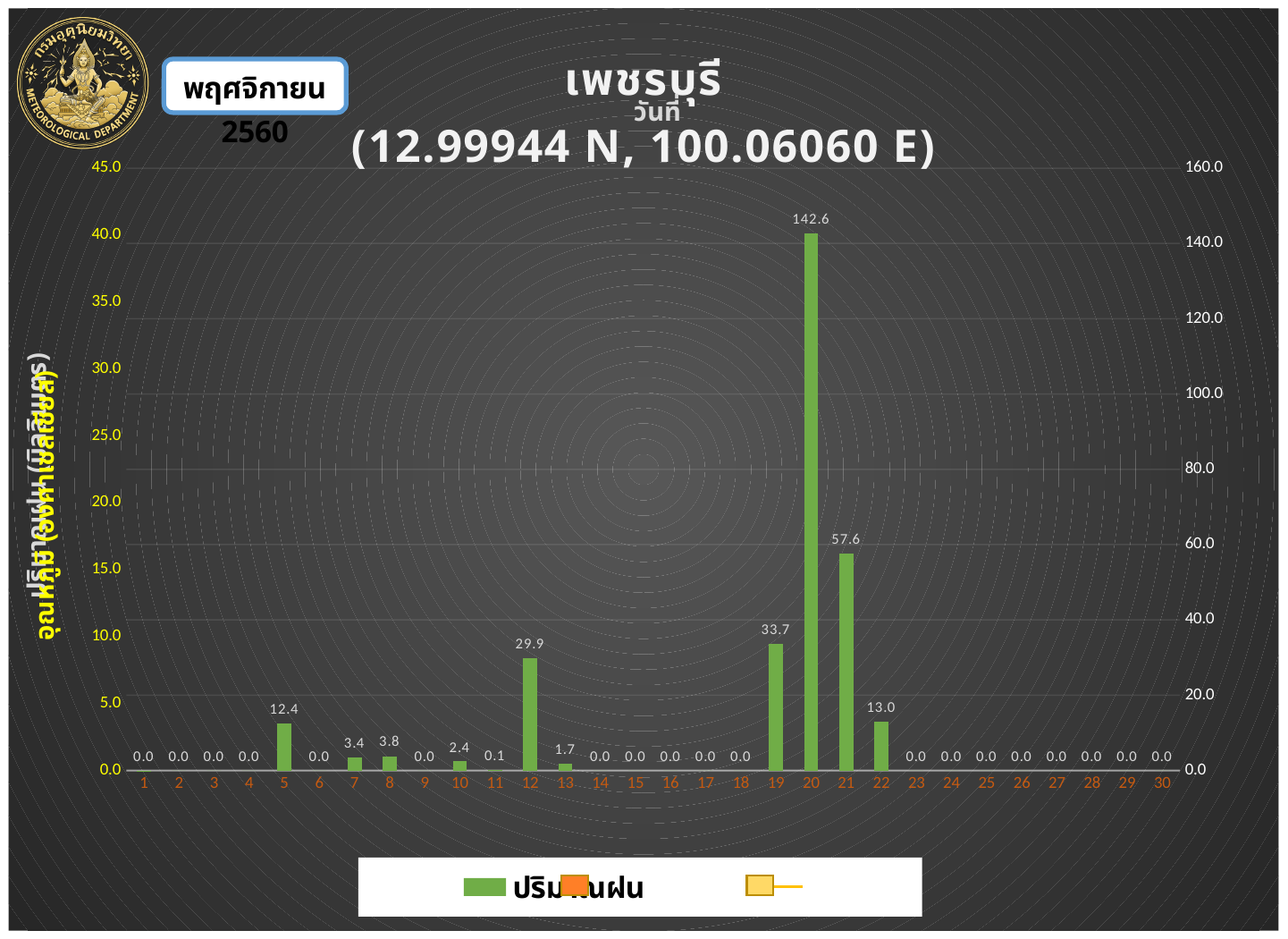
How many days are shown on the x axis? 30 What is the difference between the rainfall values for day 19 and day 12? 3.8 What kind of chart is shown on the slide? bar chart What is the difference between the rainfall values for day 20 and day 21? 85.0 What is the rainfall value shown for day 22? 13.0 What is the rainfall value shown for day 20? 142.6 Which is larger, the rainfall value for day 7 or for day 8? day 8 What is the rainfall value shown for day 12? 29.9 What are the coordinates given in the chart title? 12.99944 N, 100.06060 E Which is larger, the rainfall value for day 21 or for day 19? day 21 Which day has the highest rainfall value? 20 What is the rainfall value shown for day 5? 12.4